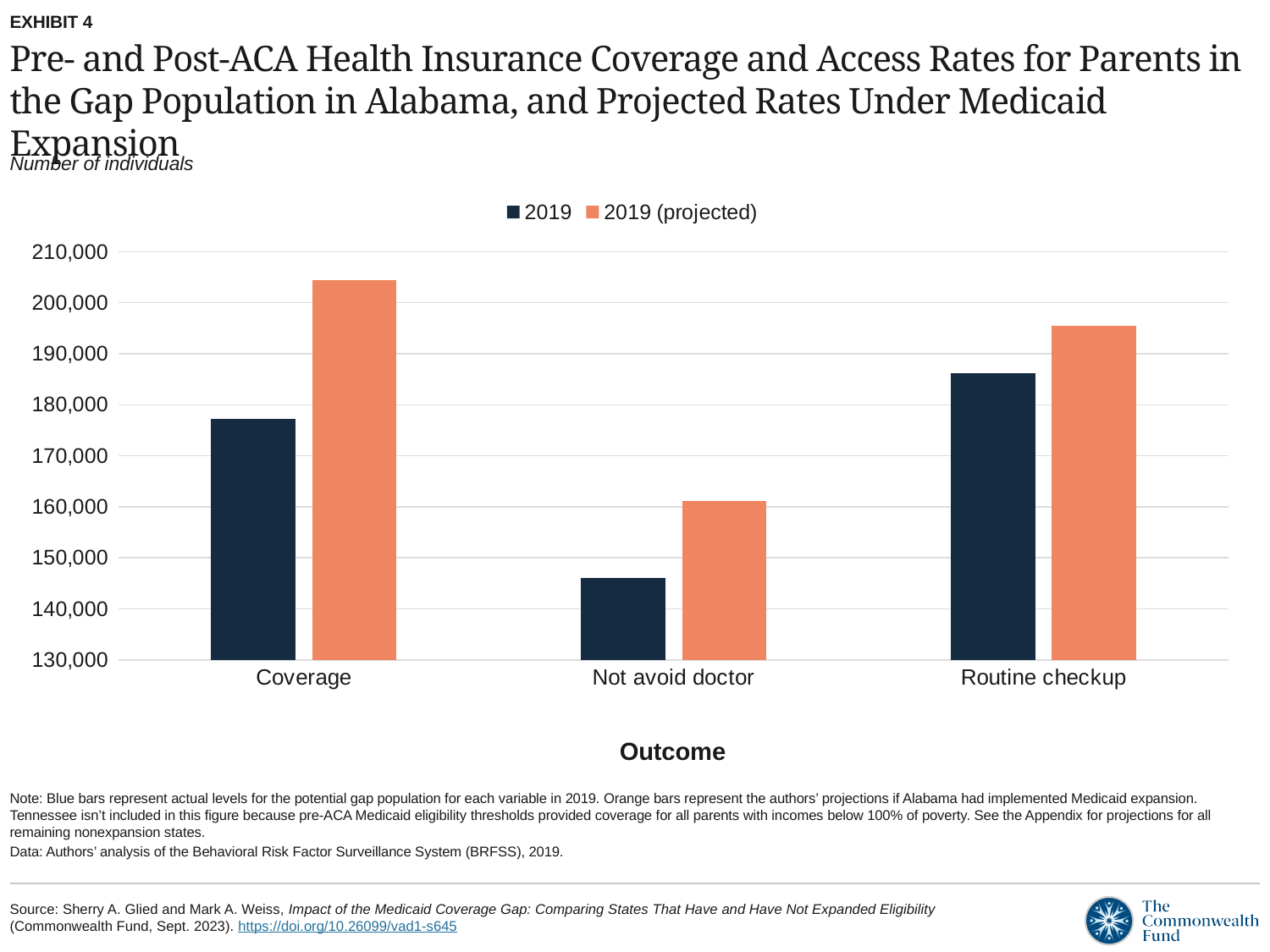
Which outcome has the lowest 2019 (actual) value? Not avoid doctor How many outcome categories are shown on the x axis? 3 Is the 2019 value for Routine checkup greater or less than 180,000? greater Which is larger: the 2019 (projected) value for Coverage or the 2019 (projected) value for Not avoid doctor? Coverage Which outcome has the highest 2019 (projected) value? Coverage How many series does the legend list? 2 Is the 2019 value for Not avoid doctor greater or less than 150,000? less What kind of chart is shown on the slide? Bar chart What is the title of the x axis? Outcome Is the 2019 (projected) value for Coverage greater or less than 200,000? greater Which outcome has the highest 2019 (actual) value? Routine checkup